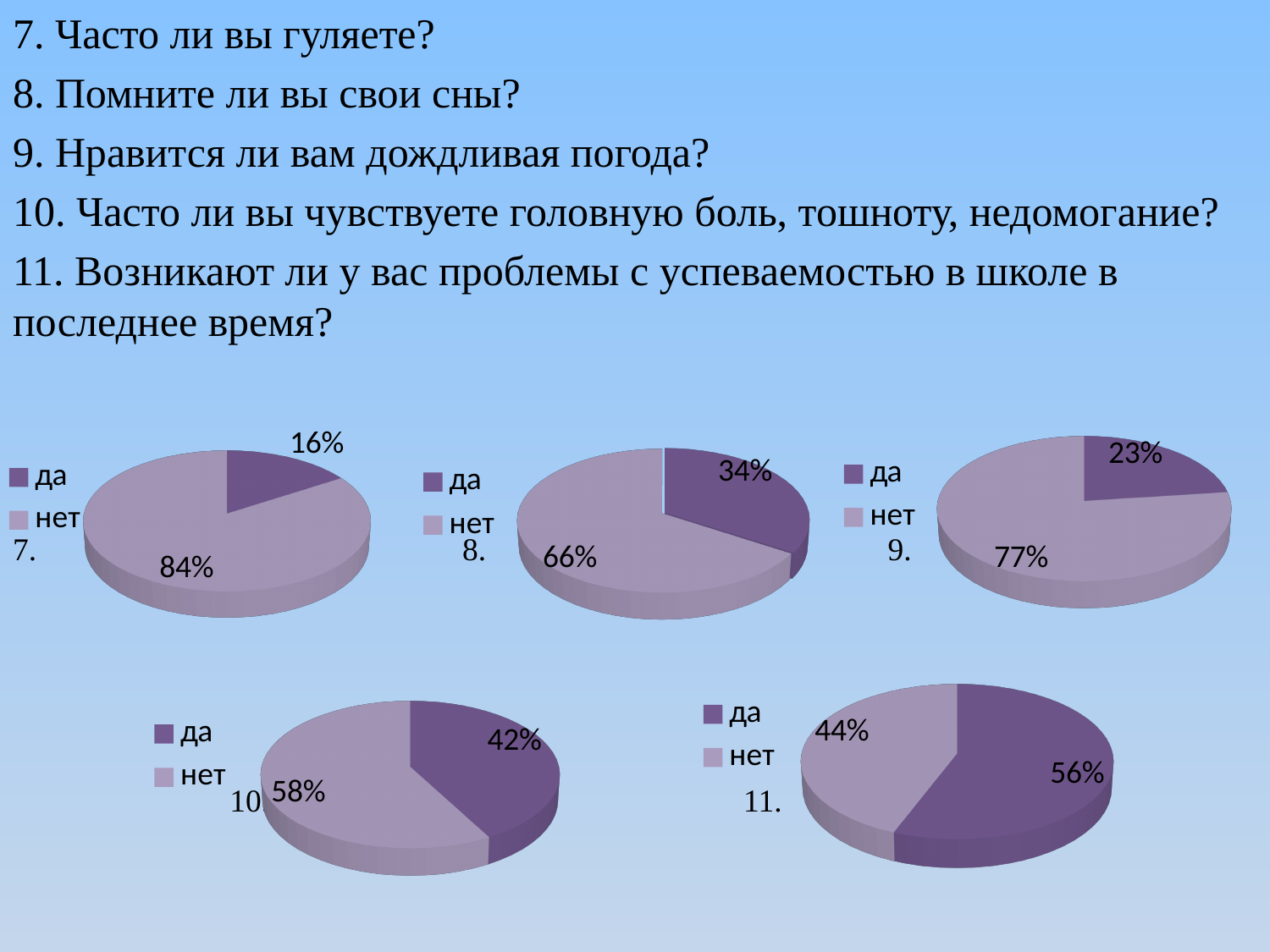
In the pie chart labelled 8, what is the difference between the "нет" and "да" shares? 32% What type of chart is the chart labelled 7? Pie chart In the pie chart labelled 9, what percentage answered "нет"? 77% In the pie chart labelled 8, what is the share for "да"? 34% In the pie chart labelled 7, what percentage answered "да"? 16% In the pie chart labelled 11, which slice is larger, "да" or "нет"? да In the pie chart labelled 10, what is the share for "нет"? 58% In the pie chart labelled 9, which slice is the smallest? да In the pie chart labelled 11, what percentage answered "да"? 56% In the pie chart labelled 7, what percentage answered "нет"? 84% In the pie chart labelled 10, what is the difference between the "нет" and "да" shares? 16% How many pie charts are shown on the slide? 5